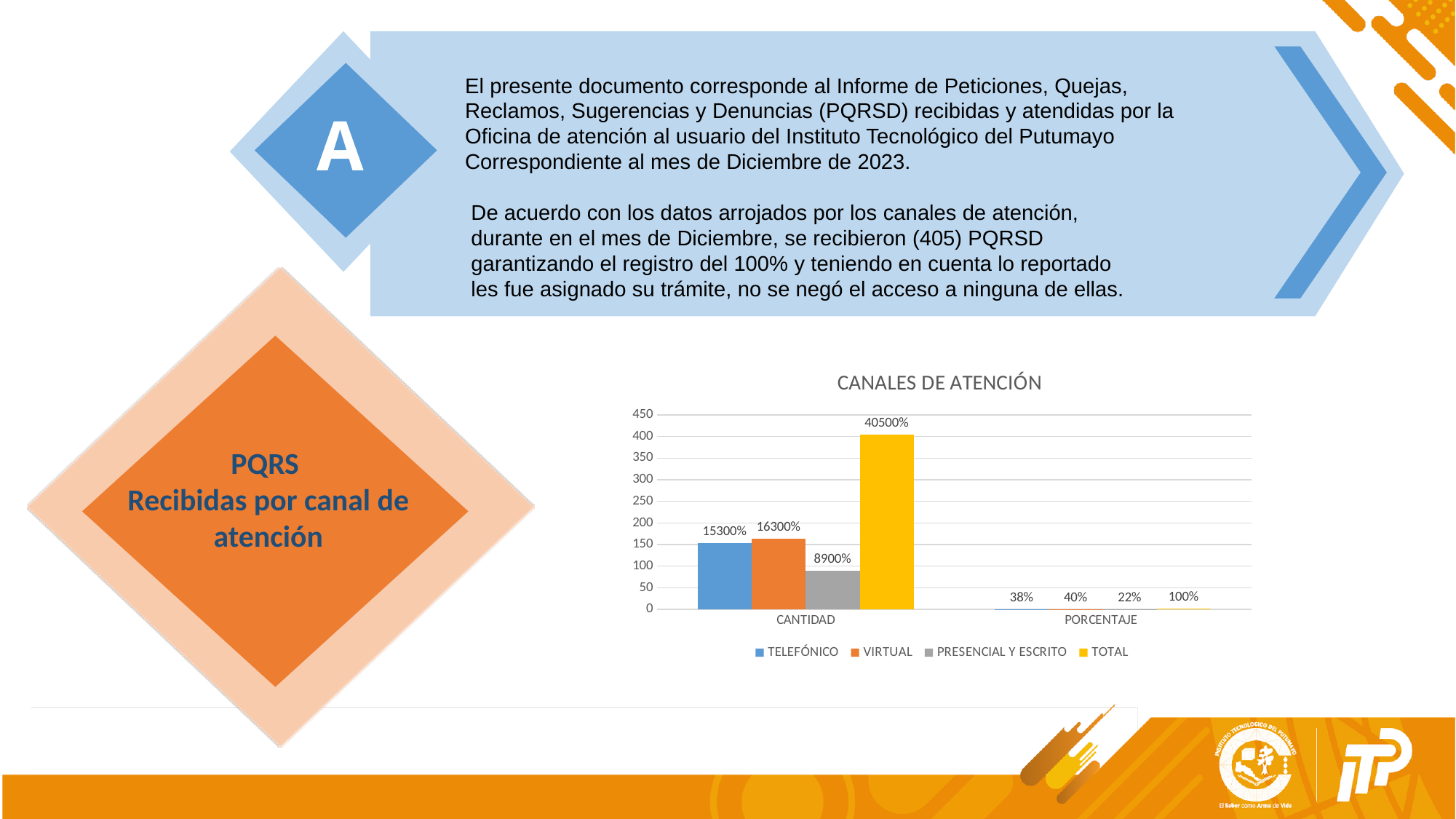
What is the data label for TELEFÓNICO in the CANTIDAD category? 15300% What is the title of the chart? CANALES DE ATENCIÓN What kind of chart is shown on the slide? bar chart Which series has the highest bar in the CANTIDAD category? TOTAL How many categories are shown on the x axis of the chart? 2 What is the data label for PRESENCIAL Y ESCRITO in the CANTIDAD category? 8900% What is the data label for VIRTUAL in the CANTIDAD category? 16300% What is the data label for TOTAL in the PORCENTAJE category? 100% Which legend entry is shown in yellow? TOTAL Which series has the lowest bar in the CANTIDAD category? PRESENCIAL Y ESCRITO What is the data label for VIRTUAL in the PORCENTAJE category? 40% How many series does the chart legend list? 4